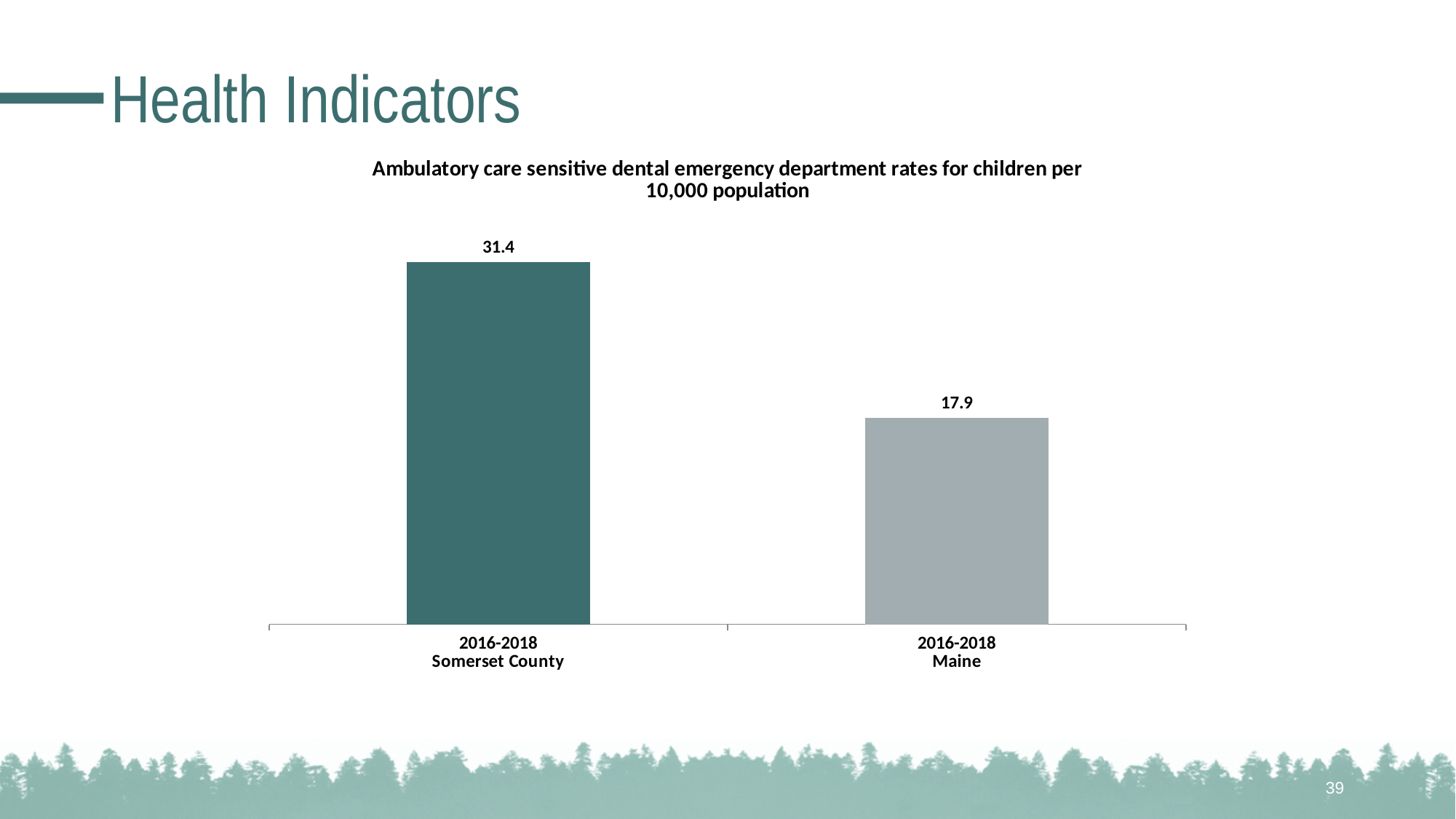
Which category has the lowest rate on the chart? Maine How many bars are shown on the chart? 2 What is the difference between the Somerset County rate and the Maine rate? 13.5 What time period do both bars on the chart cover? 2016-2018 Is the rate for Maine larger or smaller than the rate for Somerset County? smaller What kind of chart is shown on the slide? bar chart What is the ambulatory care sensitive dental emergency department rate for children per 10,000 population for Somerset County in 2016-2018? 31.4 What is the title of the chart? Ambulatory care sensitive dental emergency department rates for children per 10,000 population Which category has the higher rate, Somerset County or Maine? Somerset County What is the ambulatory care sensitive dental emergency department rate for children per 10,000 population for Maine in 2016-2018? 17.9